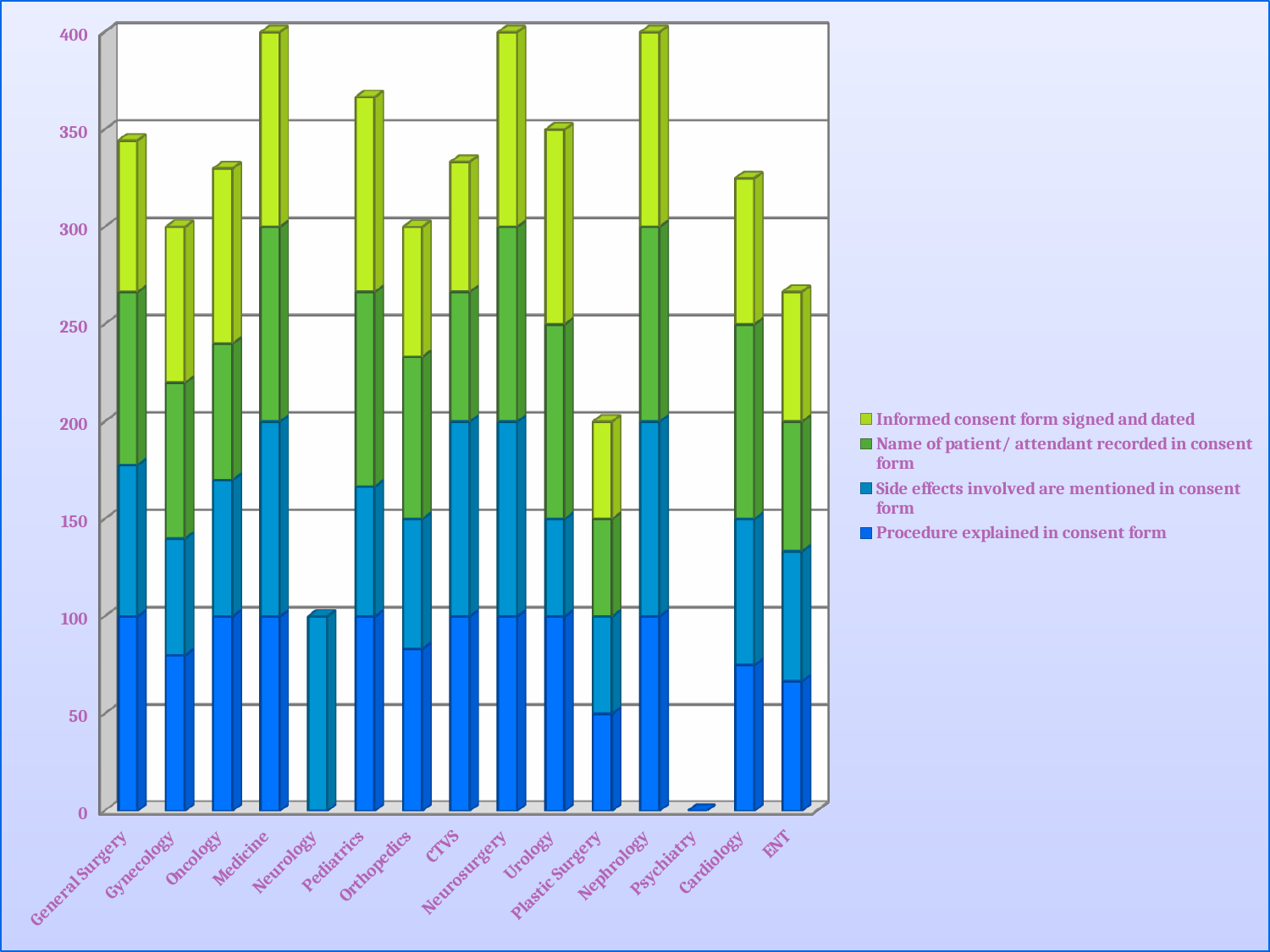
Which series is shown in the darkest blue at the bottom of each bar? Procedure explained in consent form Is the total bar for ENT greater or less than 300? less Is the total bar for Plastic Surgery greater or less than 250? less Which department has the lowest total bar? Psychiatry Which has the larger total bar, Medicine or Gynecology? Medicine Is the total bar for Neurology greater or less than 150? less How many series does the legend list? 4 What kind of chart is shown on the slide? stacked bar chart Which has the larger total bar, Urology or Plastic Surgery? Urology How many departments are shown along the x axis? 15